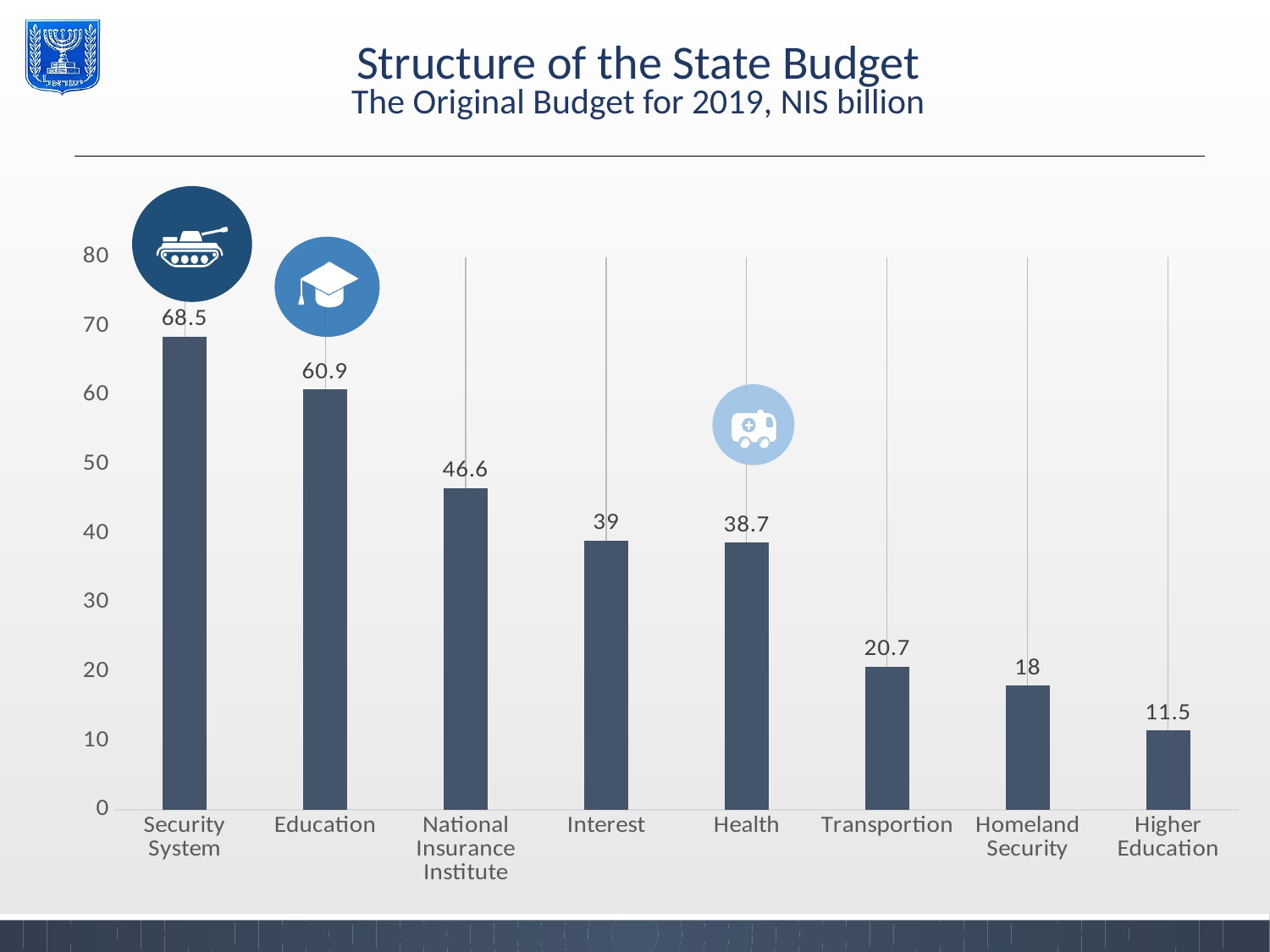
What is the difference between the values for Homeland Security and Higher Education? 6.5 What is the value for Security System? 68.5 Do the values rise or fall from left to right along the x axis? fall Which category has the highest value? Security System What is the value for National Insurance Institute? 46.6 Which is larger, the value for Education or the value for Health? Education What kind of chart is shown on the slide? bar chart Which category has the lowest value? Higher Education Is the value for Interest greater or less than 40? less What is the value for Transportion? 20.7 How many categories are shown on the chart? 8 What is the difference between the values for Security System and Education? 7.6